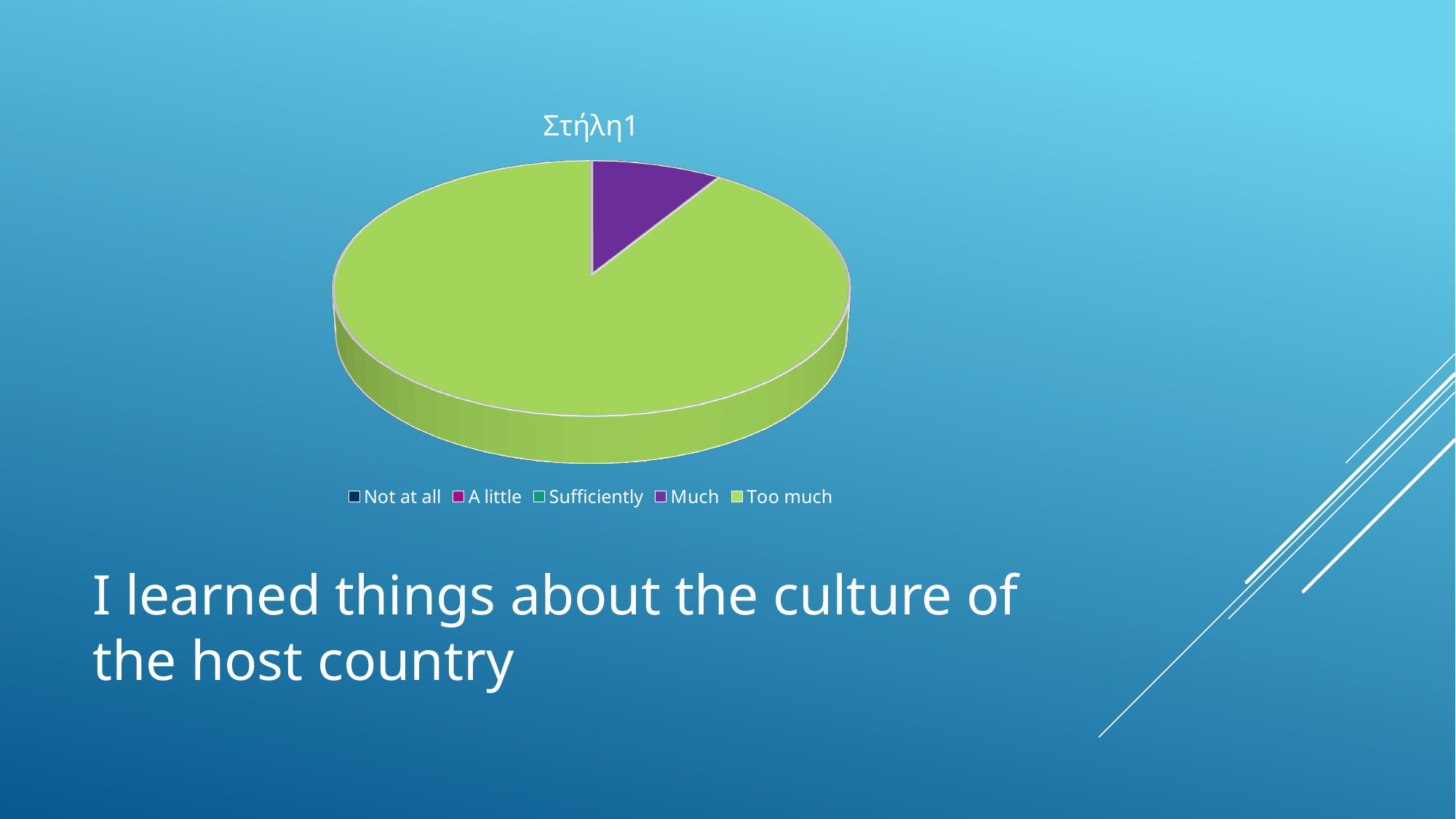
Which category is shown in purple in the pie? Much Which category has the largest slice of the pie? Too much How many slices are visible in the pie? 2 What is the title of the chart? Στήλη1 Which of the two visible slices is the smaller one? Much Which is larger, the slice for Too much or the slice for Much? Too much What kind of chart is shown on the slide? pie chart How many categories does the chart's legend list? 5